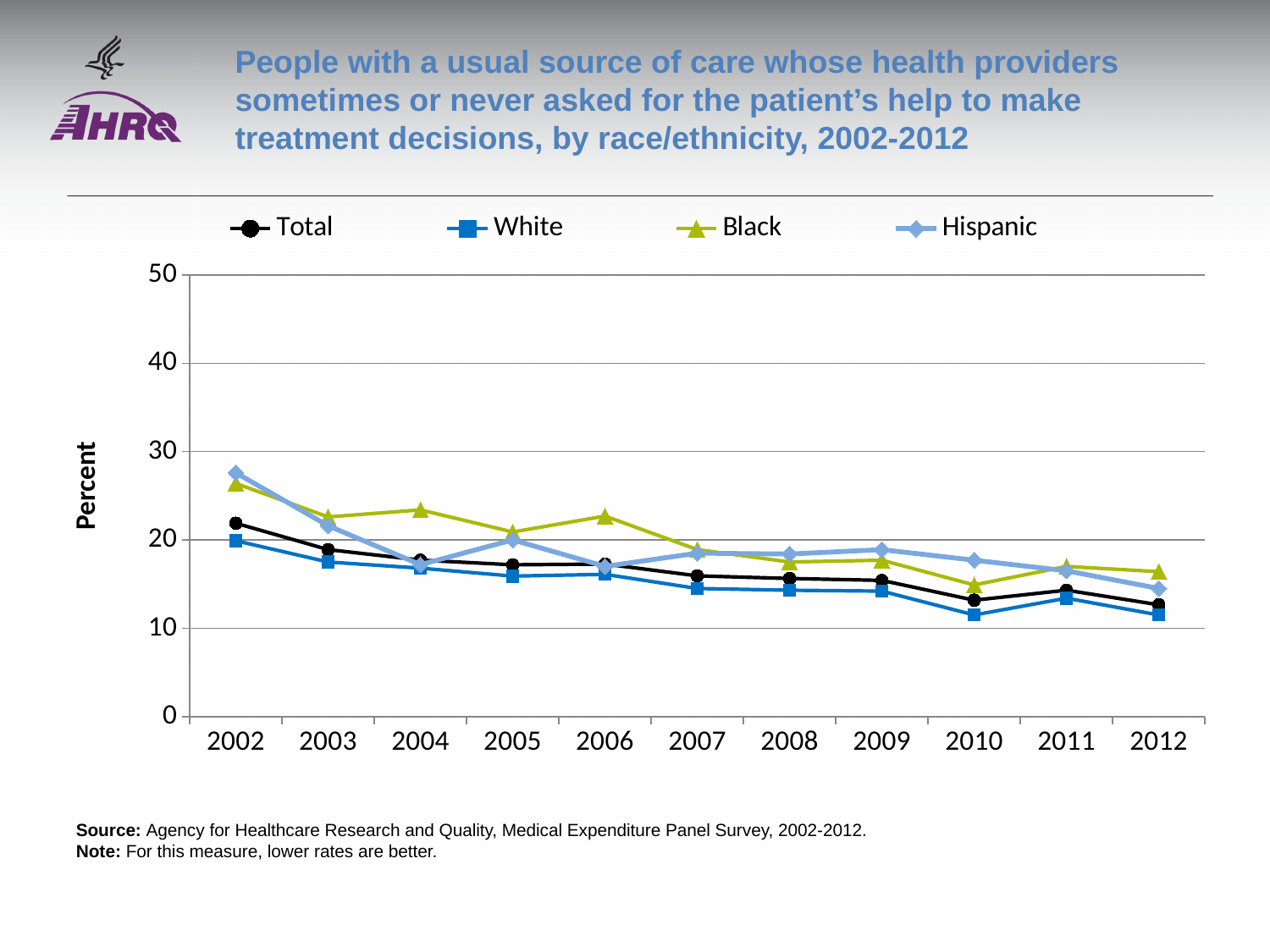
Does the Total series generally rise or fall from 2002 to 2012? fall How many years are plotted along the x axis? 11 Is the value for White in 2012 greater or less than 20? less Is the value for Black in 2004 greater or less than 20? greater Does the White series generally rise or fall from 2002 to 2012? fall Is the value for White in 2010 greater or less than 10? greater Which series has the lowest value in 2012? White What kind of chart is shown on the slide? line chart In which year does the Hispanic series reach its highest value? 2002 How many series does the legend list? 4 In 2012, which is larger, the value for Black or the value for White? Black